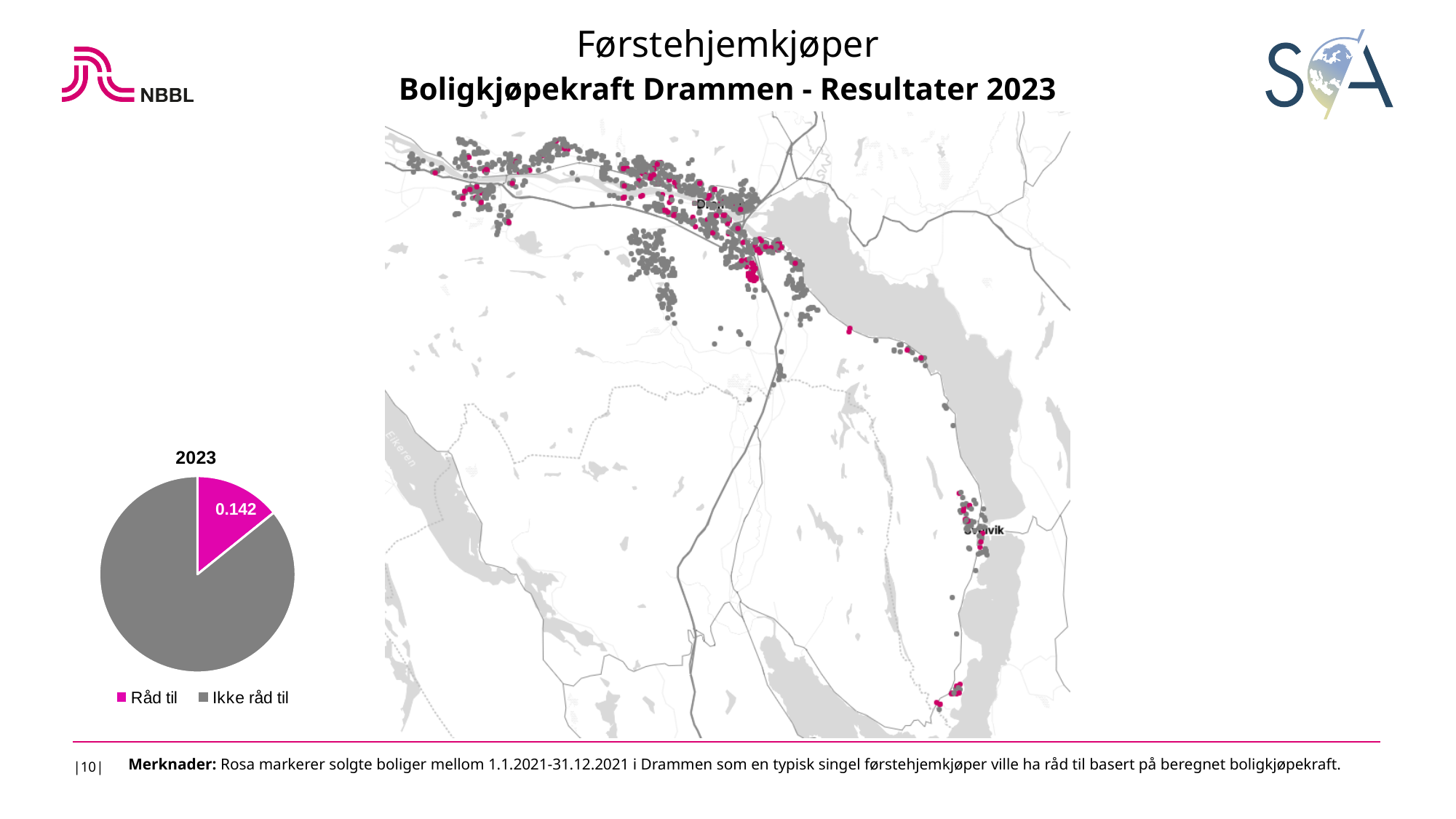
What kind of chart is shown in the lower left of the slide? pie chart What share of the pie chart titled 2023 does the Råd til slice represent, as labelled? 0.142 In the pie chart titled 2023, which category has the smallest slice? Råd til In the pie chart titled 2023, what value is labelled on the Råd til slice? 0.142 In the pie chart titled 2023, which category has the largest slice? Ikke råd til How many slices does the pie chart titled 2023 have? 2 What is the title shown above the pie chart? 2023 In the pie chart titled 2023, which slice is larger, Råd til or Ikke råd til? Ikke råd til How many entries does the legend of the pie chart list? 2 What colour is the Råd til slice in the pie chart? pink